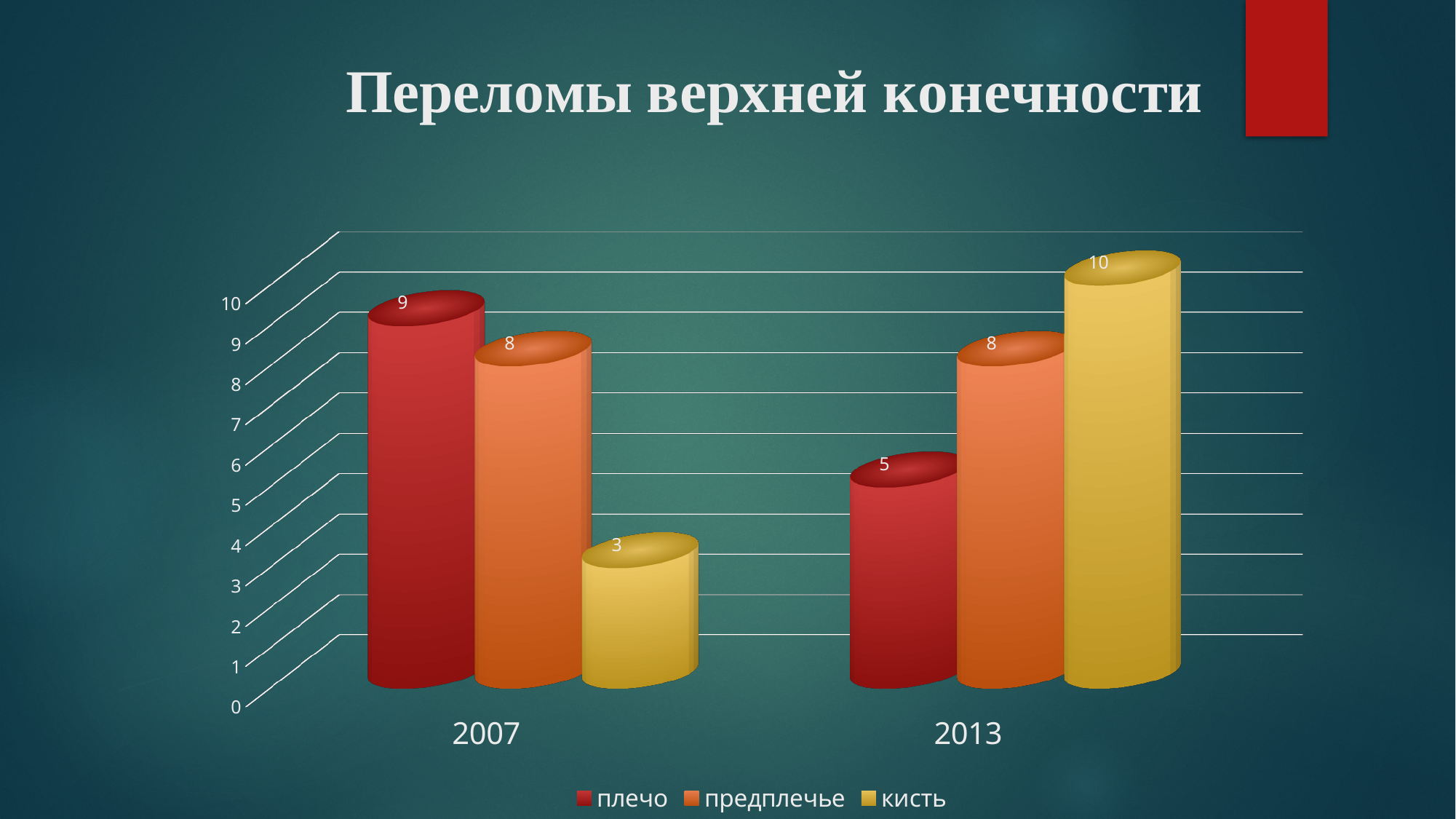
Which is larger, the плечо value in 2007 or in 2013? 2007 Which series has the highest value in 2013? кисть How many categories are shown on the x axis? 2 What is the value for плечо in 2013? 5 What is the title of the chart? Переломы верхней конечности What is the difference between the кисть values for 2013 and 2007? 7 How many series does the legend list? 3 What is the value for предплечье in 2007? 8 Which series has the lowest value in 2007? кисть What kind of chart is shown on the slide? bar chart What is the value for плечо in 2007? 9 What is the value for кисть in 2013? 10